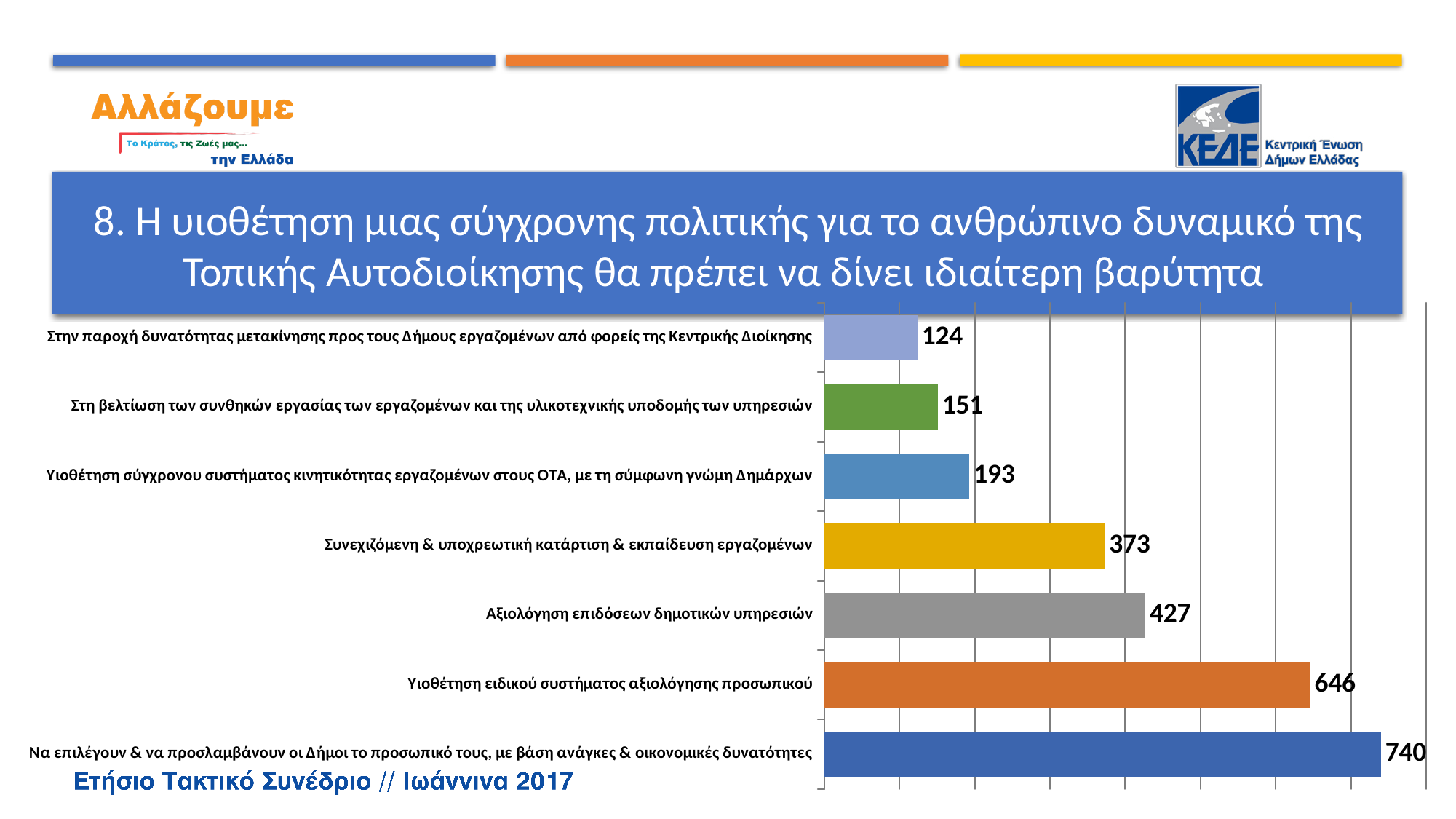
Which category has the lowest value? Στην παροχή δυνατότητας μετακίνησης προς τους Δήμους εργαζομένων από φορείς της Κεντρικής Διοίκησης What value is shown for "Υιοθέτηση ειδικού συστήματος αξιολόγησης προσωπικού"? 646 How many categories are shown in the chart? 7 What value is shown for "Υιοθέτηση σύγχρονου συστήματος κινητικότητας εργαζομένων στους ΟΤΑ, με τη σύμφωνη γνώμη Δημάρχων"? 193 What value is shown for "Αξιολόγηση επιδόσεων δημοτικών υπηρεσιών"? 427 What kind of chart is shown on the slide? Bar chart Which is larger: the value for "Στη βελτίωση των συνθηκών εργασίας των εργαζομένων και της υλικοτεχνικής υποδομής των υπηρεσιών" or the value for "Στην παροχή δυνατότητας μετακίνησης προς τους Δήμους εργαζομένων από φορείς της Κεντρικής Διοίκησης"? Στη βελτίωση των συνθηκών εργασίας των εργαζομένων και της υλικοτεχνικής υποδομής των υπηρεσιών What colour is the bar for "Συνεχιζόμενη & υποχρεωτική κατάρτιση & εκπαίδευση εργαζομένων"? Yellow What is the difference between the highest and lowest values in the chart? 616 Which category has the highest value? Να επιλέγουν & να προσλαμβάνουν οι Δήμοι το προσωπικό τους, με βάση ανάγκες & οικονομικές δυνατότητες What is the difference between the values for "Υιοθέτηση ειδικού συστήματος αξιολόγησης προσωπικού" and "Αξιολόγηση επιδόσεων δημοτικών υπηρεσιών"? 219 What value is shown for "Συνεχιζόμενη & υποχρεωτική κατάρτιση & εκπαίδευση εργαζομένων"? 373